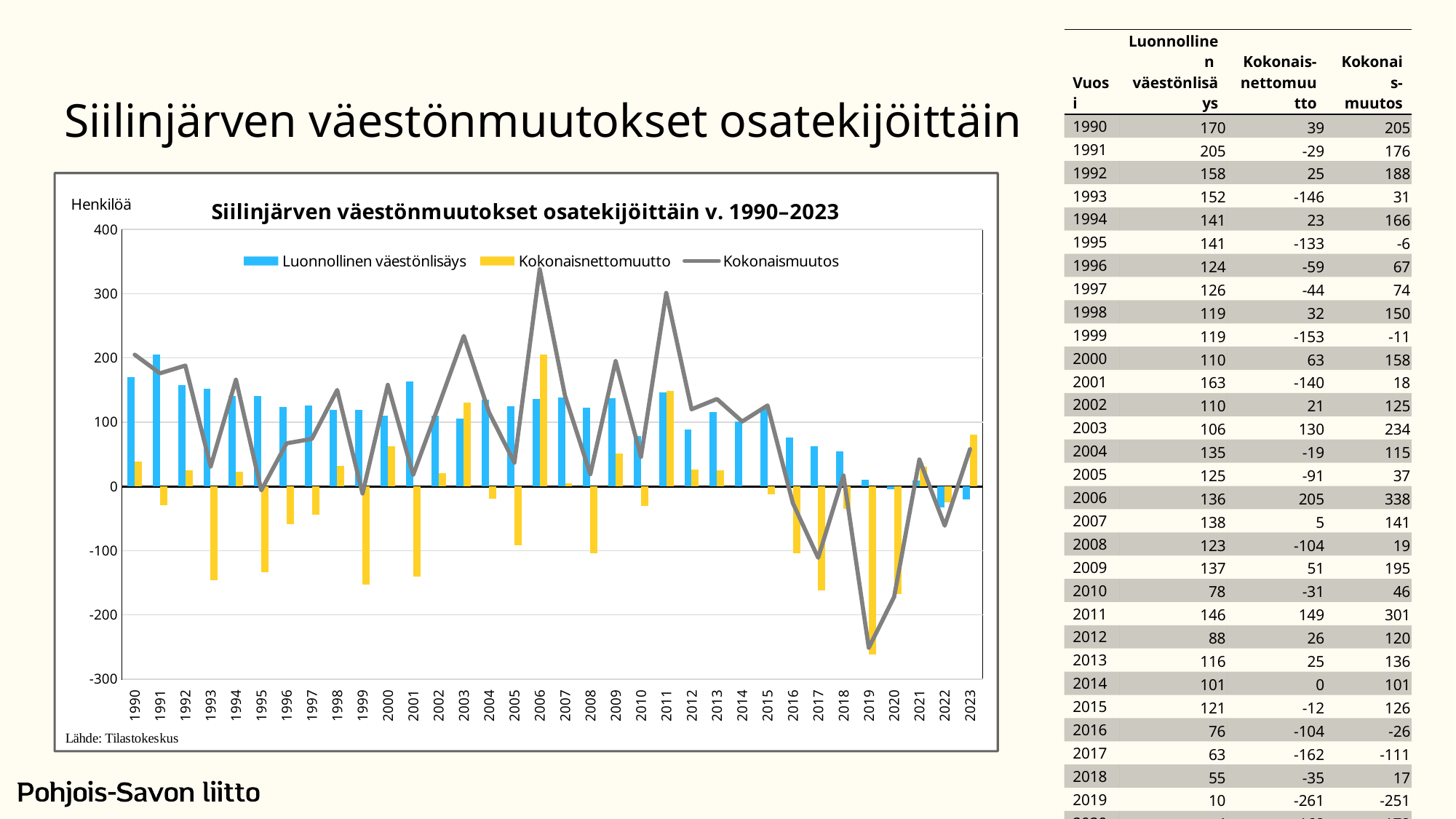
What kind of chart is shown on the slide? A combined bar and line chart In which year is Kokonaismuutos highest? 2006 What is the title of the chart? Siilinjärven väestönmuutokset osatekijöittäin v. 1990–2023 How many years are shown on the x axis of the chart? 34 What is the difference between Luonnollinen väestönlisäys in 1991 and in 1990? 35 In which year is Kokonaismuutos lowest? 2019 Is the value of Kokonaisnettomuutto for 2019 greater or less than -200? less How many series does the chart legend list? 3 Which year has the larger Luonnollinen väestönlisäys, 1991 or 2019? 1991 What is the value of Kokonaisnettomuutto for 2006? 205 What is the value of Luonnollinen väestönlisäys for 1990? 170 Does Luonnollinen väestönlisäys rise or fall from 2011 to 2019? fall